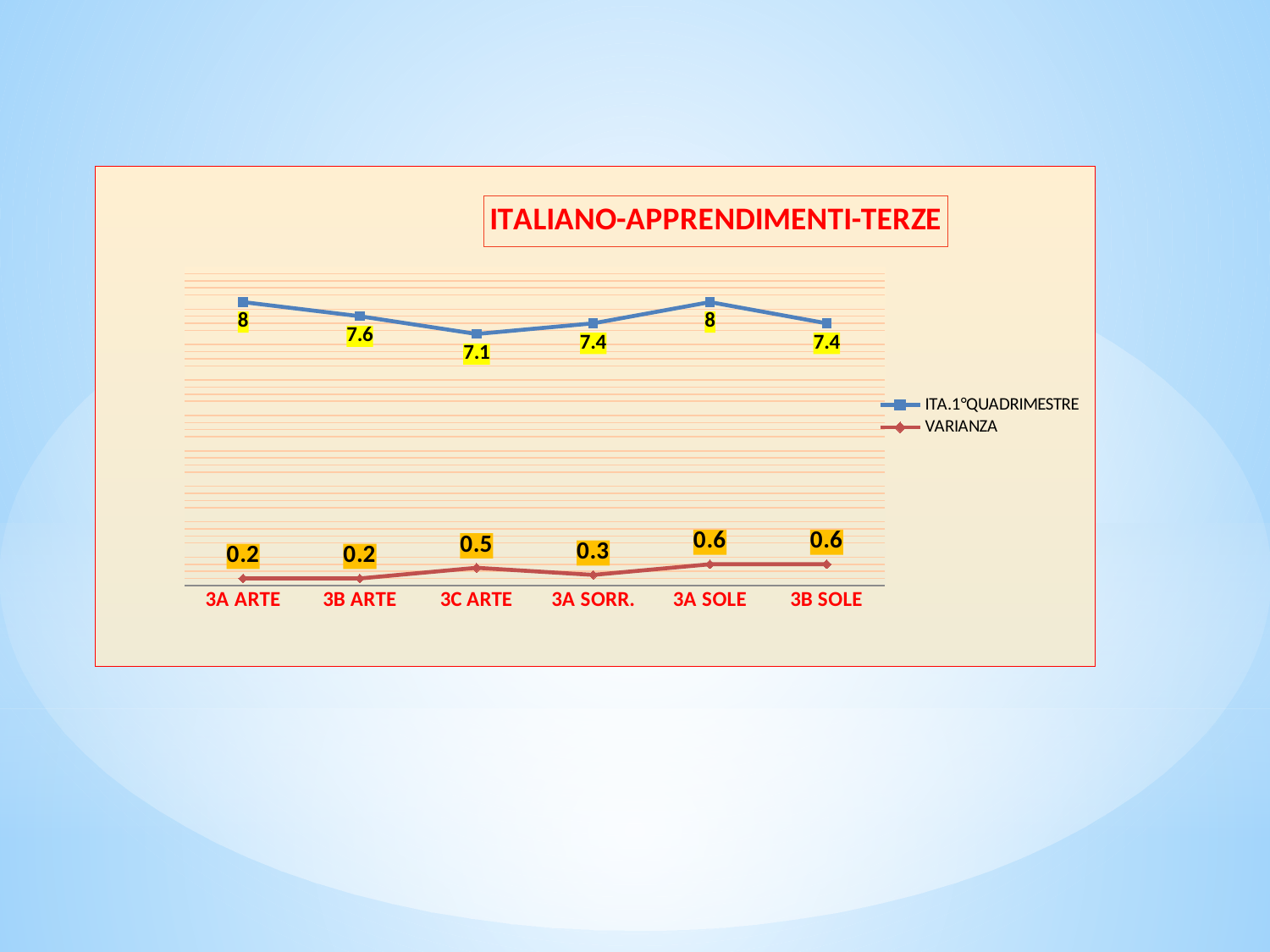
What is the difference between the VARIANZA values for 3A SOLE and 3A ARTE? 0.4 What is the ITA.1°QUADRIMESTRE value for 3C ARTE? 7.1 Which category has the lowest ITA.1°QUADRIMESTRE value? 3C ARTE How many series does the legend list? 2 Which categories share the highest ITA.1°QUADRIMESTRE value? 3A ARTE and 3A SOLE How many categories are shown on the x axis? 6 What is the title of the chart? ITALIANO-APPRENDIMENTI-TERZE What is the ITA.1°QUADRIMESTRE value for 3B ARTE? 7.6 What kind of chart is shown? Line chart What is the difference between the ITA.1°QUADRIMESTRE values for 3A ARTE and 3C ARTE? 0.9 What is the VARIANZA value for 3A SORR.? 0.3 Which is larger, the VARIANZA for 3C ARTE or for 3A SORR.? 3C ARTE